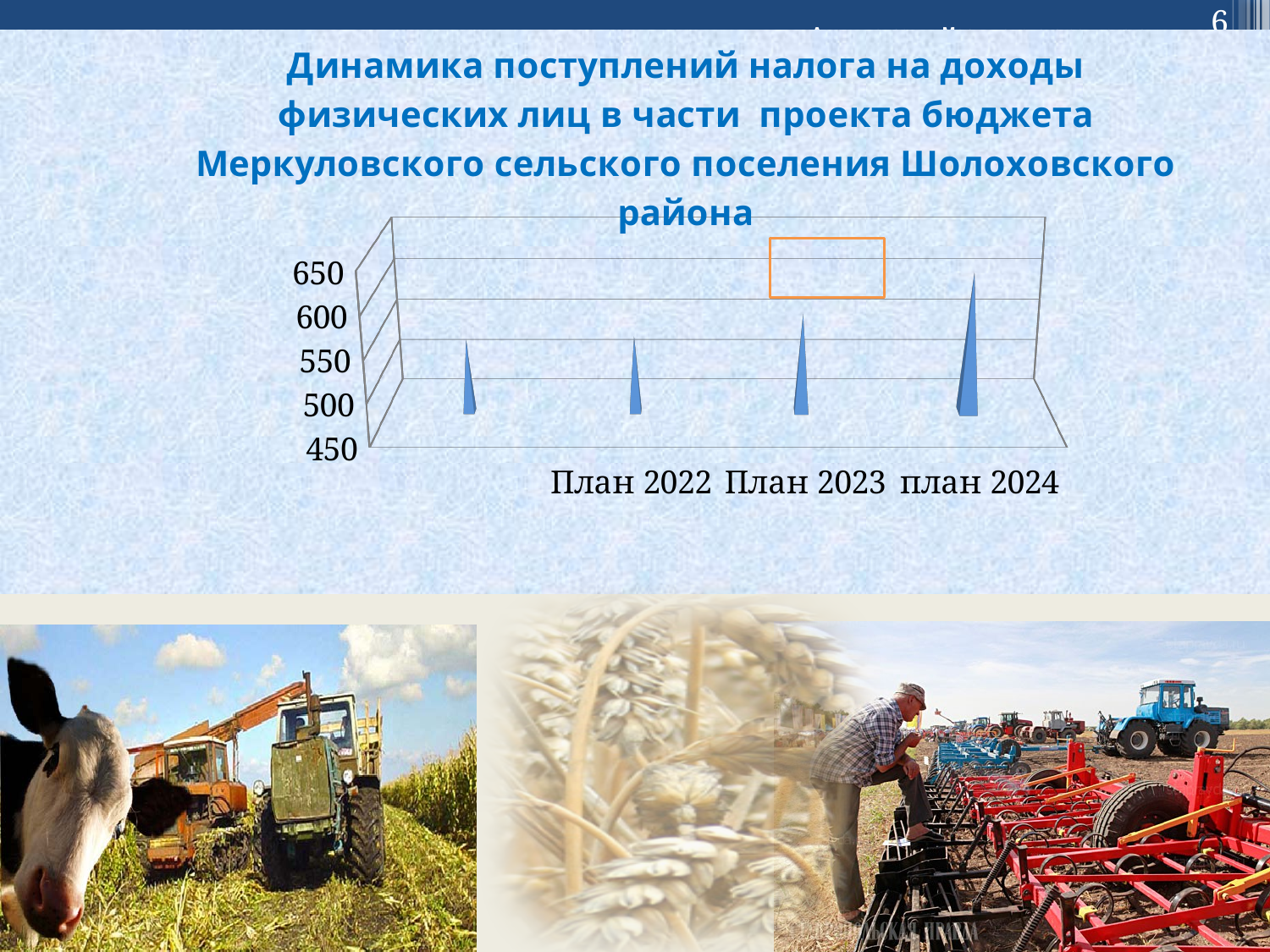
What is the lowest value shown on the vertical axis of the chart? 450 How many category labels are shown on the x axis of the chart? 3 What is the highest value shown on the vertical axis of the chart? 650 Is the value for План 2022 greater or less than 600? less Is the value for План 2023 greater or less than 500? greater Is the value for план 2024 greater or less than 550? greater Which category has the highest value in the chart? план 2024 What kind of chart is shown on the slide? bar chart Do the values rise or fall from План 2022 to план 2024? rise Which is larger, the value for План 2022 or the value for план 2024? план 2024